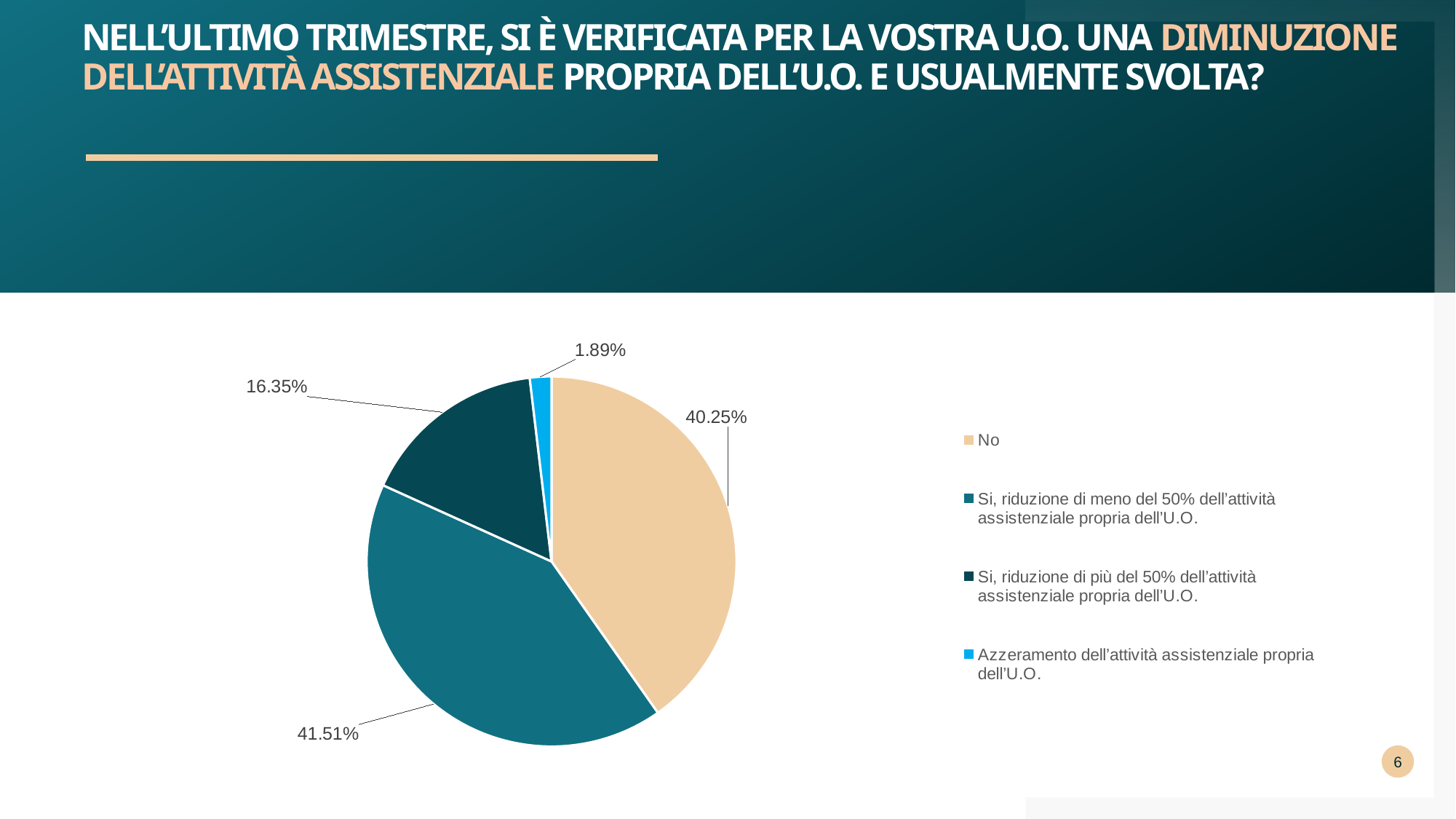
What is the combined share of the two "Si" responses (riduzione di meno del 50% and riduzione di più del 50%)? 57.86% What share of respondents answered "No"? 40.25% What share of respondents answered "Si, riduzione di più del 50% dell'attività assistenziale propria dell'U.O."? 16.35% What colour is the slice for "Azzeramento dell'attività assistenziale propria dell'U.O."? light blue Which response has the largest slice of the pie? Si, riduzione di meno del 50% dell'attività assistenziale propria dell'U.O. How many slices does the pie chart have? 4 What is the difference in percentage points between the "No" slice and the "Si, riduzione di più del 50%" slice? 23.90 What kind of chart is shown on the slide? pie chart Which response has the smallest slice of the pie? Azzeramento dell'attività assistenziale propria dell'U.O. What share of respondents answered "Azzeramento dell'attività assistenziale propria dell'U.O."? 1.89% Which is larger: the "No" slice or the "Si, riduzione di meno del 50%" slice? Si, riduzione di meno del 50% dell'attività assistenziale propria dell'U.O. What share of respondents answered "Si, riduzione di meno del 50% dell'attività assistenziale propria dell'U.O."? 41.51%